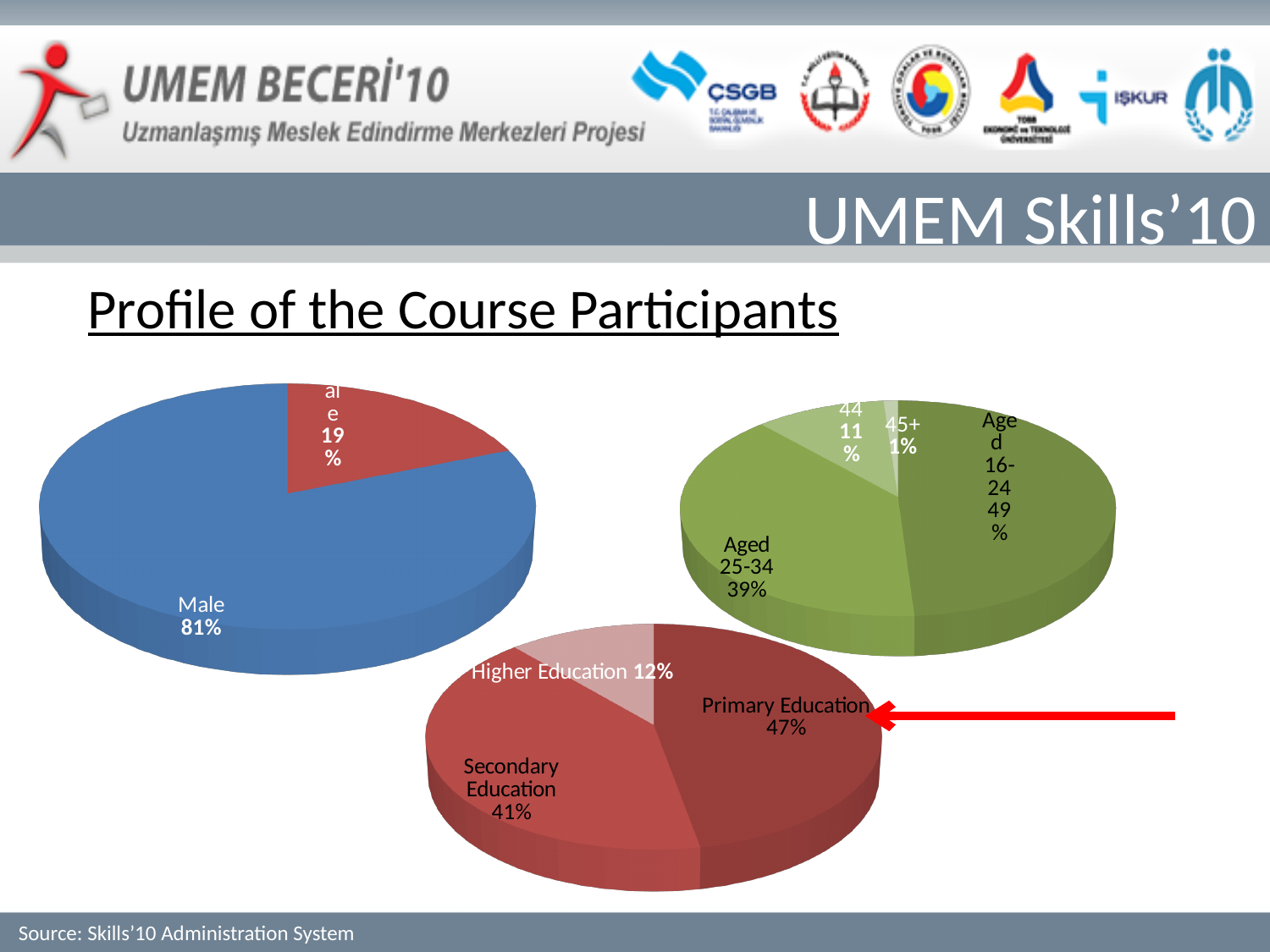
In the bottom pie chart, which is larger: Secondary Education or Higher Education? Secondary Education In the bottom pie chart, what percentage of participants have Primary Education? 47% In the left pie chart, what percentage is shown for the smaller (red) slice? 19% In the left pie chart, what percentage of course participants are Male? 81% In the top-right pie chart, which age group has the smallest share? 45+ In the top-right pie chart, what percentage of participants are Aged 25-34? 39% In the top-right pie chart, what percentage of participants are aged 45+? 1% In the left pie chart, which slice is the largest? Male What type of chart is used for the education breakdown at the bottom of the slide? Pie chart In the top-right pie chart, how many slices are there? 4 In the left pie chart, what is the difference in percentage points between the Male slice and the red slice? 62 In the top-right pie chart, what percentage of participants are Aged 16-24? 49%